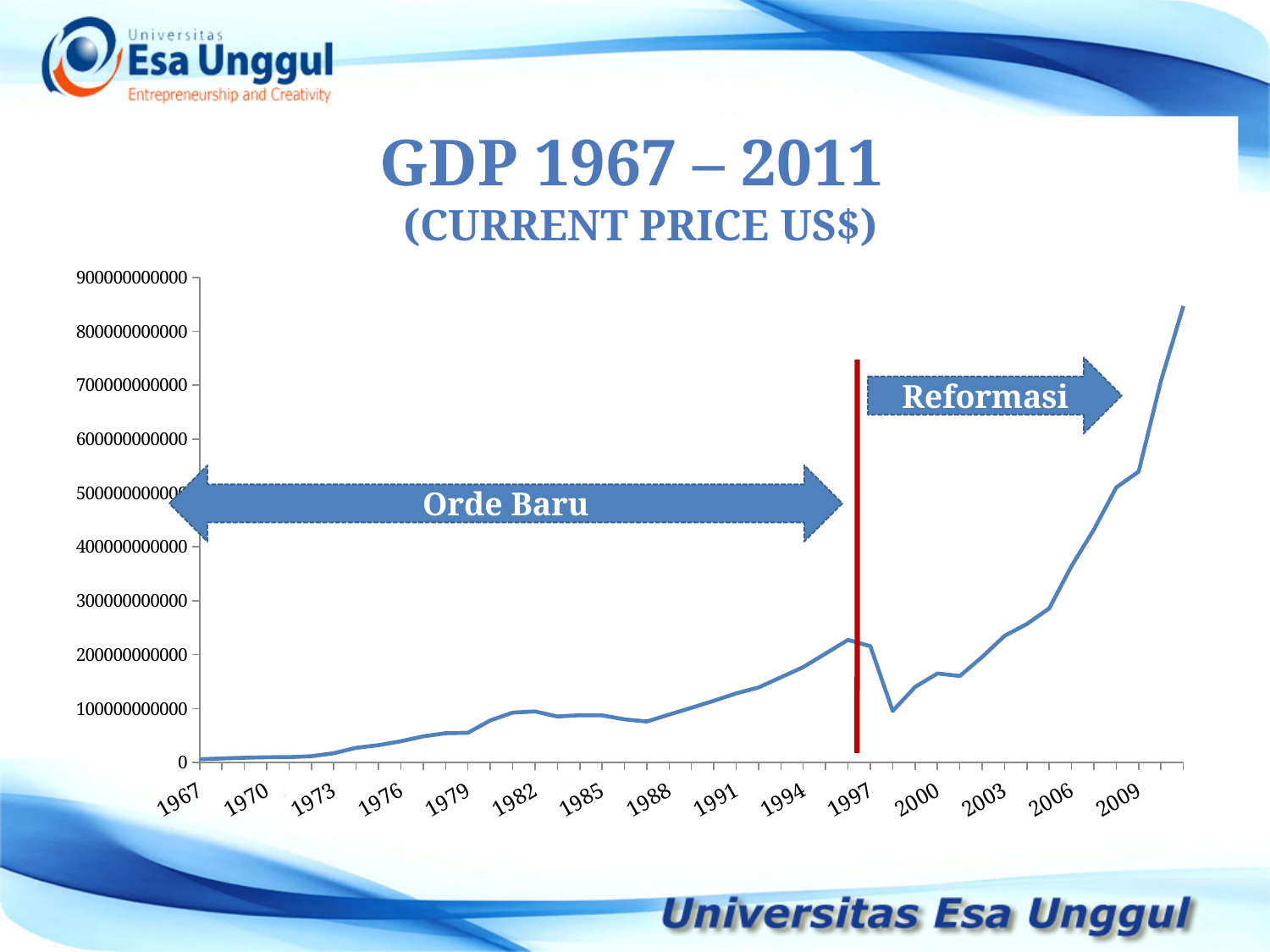
Which year has the higher GDP, 2006 or 2009? 2009 How many year labels are shown on the x axis? 15 What kind of chart is shown on the slide? line chart Is the GDP value for 2003 greater or less than 200000000000? greater Is the GDP value at the last point of the series greater or less than 800000000000? greater Overall, does GDP rise or fall from 1967 to the end of the series? rise What label is on the arrow to the right of the red vertical line? Reformasi What is the title of the chart? GDP 1967 – 2011 (CURRENT PRICE US$) Is the GDP value for 2009 greater or less than 500000000000? greater Which year has the higher GDP, 1997 or 2000? 1997